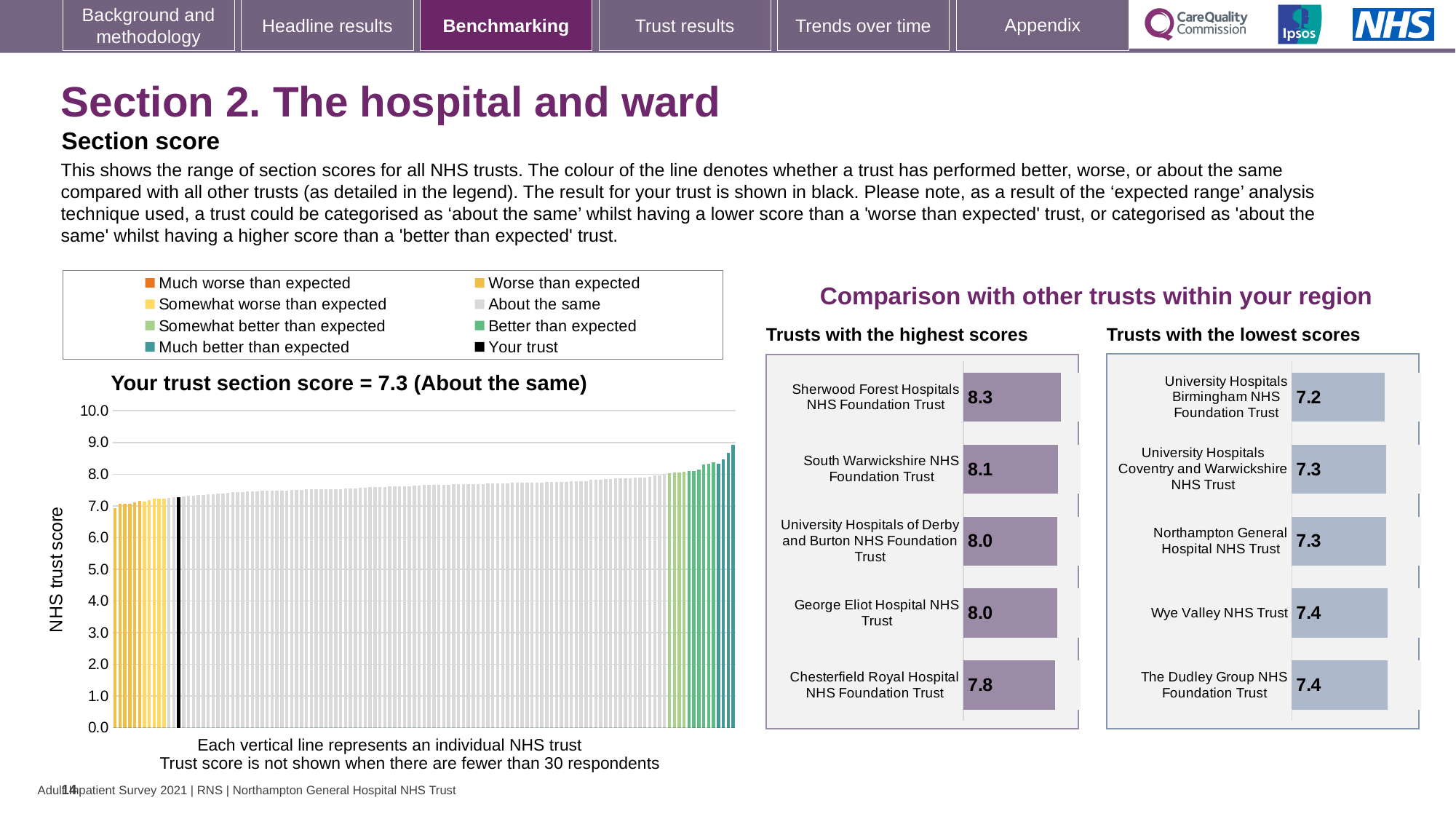
In the 'Trusts with the highest scores' chart, which trust has the highest score? Sherwood Forest Hospitals NHS Foundation Trust How many entries does the legend above the main 'Your trust section score' chart list? 8 In the 'Trusts with the lowest scores' chart, what is the score for Wye Valley NHS Trust? 7.4 In the 'Trusts with the highest scores' chart, what is the score for Sherwood Forest Hospitals NHS Foundation Trust? 8.3 In the 'Trusts with the lowest scores' chart, what is the score for University Hospitals Birmingham NHS Foundation Trust? 7.2 In the 'Trusts with the lowest scores' chart, which trust has the lowest score? University Hospitals Birmingham NHS Foundation Trust In the main 'Your trust section score' chart, do the bar values rise or fall from left to right along the x axis? rise Which has the higher score: Sherwood Forest Hospitals NHS Foundation Trust in the 'highest scores' chart or University Hospitals Birmingham NHS Foundation Trust in the 'lowest scores' chart? Sherwood Forest Hospitals NHS Foundation Trust In the main 'Your trust section score' chart, is the value of the tallest bar greater or less than 8.0? greater In the 'Trusts with the highest scores' chart, what is the difference between the scores of Sherwood Forest Hospitals NHS Foundation Trust and Chesterfield Royal Hospital NHS Foundation Trust? 0.5 How many trusts are listed in the 'Trusts with the lowest scores' chart? 5 In the 'Trusts with the highest scores' chart, what is the score for Chesterfield Royal Hospital NHS Foundation Trust? 7.8